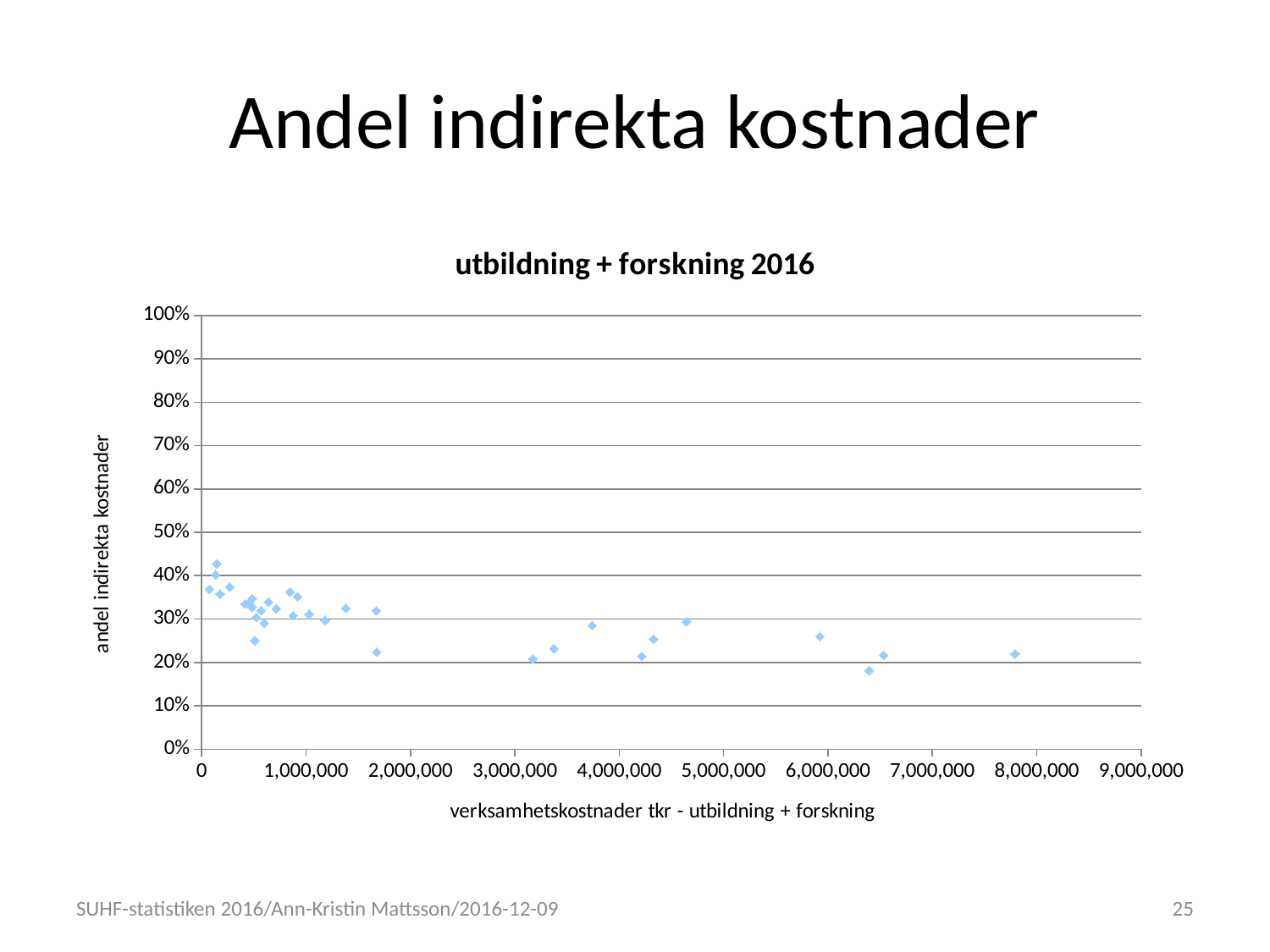
What kind of chart is shown on the slide? scatter chart Are any of the plotted points above 50%? no What is the label of the vertical axis? andel indirekta kostnader Is the value for the highest point on the chart greater or less than 40%? greater Is the value for the lowest point on the chart greater or less than 20%? less Which has the higher share of indirect costs: the highest point in the cluster below 1,000,000 tkr or the rightmost point near 7,800,000 tkr? the point below 1,000,000 tkr Do the plotted values generally rise or fall as verksamhetskostnader increases along the x axis? fall What is the title of the chart? utbildning + forskning 2016